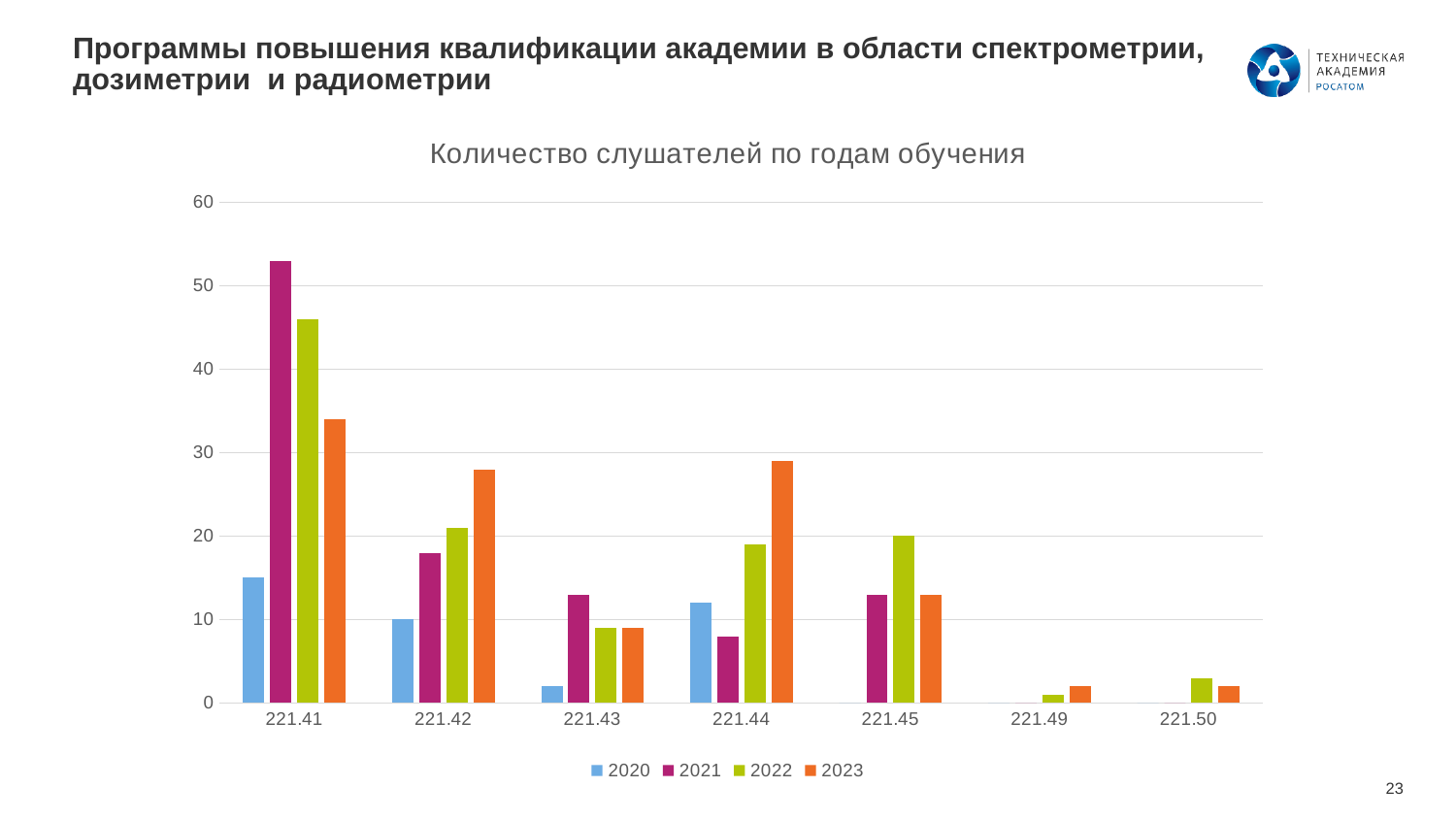
What is the title of the chart? Количество слушателей по годам обучения Is the value for 2021 in program 221.41 greater or less than 50? greater Which year is represented by the orange bars? 2023 What kind of chart is shown on the slide? bar chart For program 221.41, which year has the highest value? 2021 Is the value for 2020 in program 221.43 greater or less than 10? less Which is larger for program 221.45: the 2022 value or the 2021 value? 2022 Which program category has the tallest bar in the chart? 221.41 How many program categories are shown on the x axis? 7 Which is larger for program 221.42: the 2022 value or the 2023 value? 2023 Is the value for 2023 in program 221.44 greater or less than 20? greater How many series does the legend list? 4